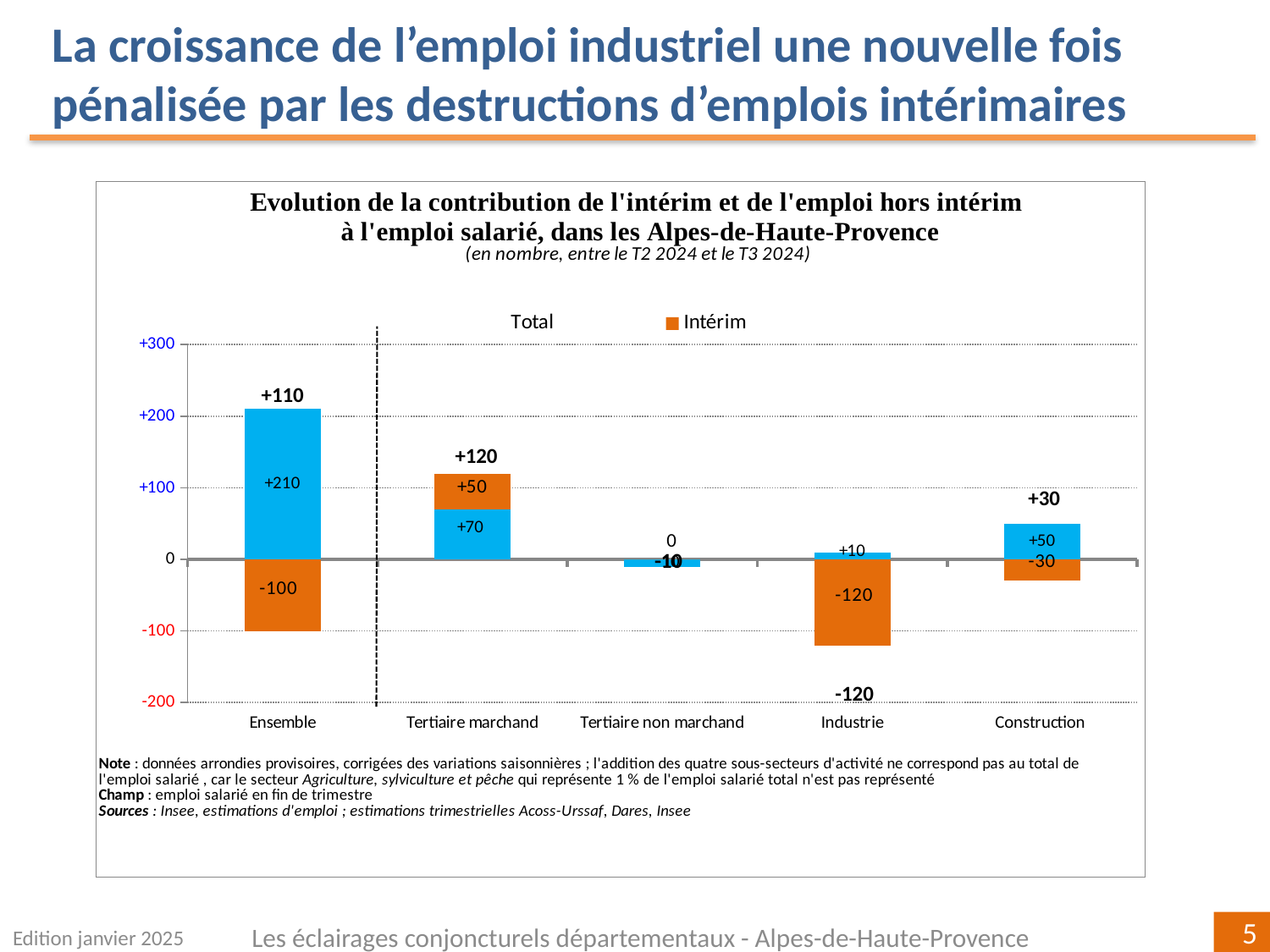
Which category has the lowest total (bold label)? Industrie What is the value of the blue (hors intérim) segment for Tertiaire marchand? +70 What is the Intérim value for Industrie? -120 Which is larger: the Intérim value for Tertiaire marchand or the Intérim value for Construction? Tertiaire marchand What is the Intérim value for Ensemble? -100 What is the total (bold label) for Ensemble? +110 Which category has the highest total (bold label)? Tertiaire marchand What is the total (bold label) for Construction? +30 How many categories are shown on the x axis? 5 What colour represents the Intérim series in the legend? Orange What is the difference between the total for Tertiaire marchand and the total for Construction? 90 What kind of chart is this? Stacked bar chart